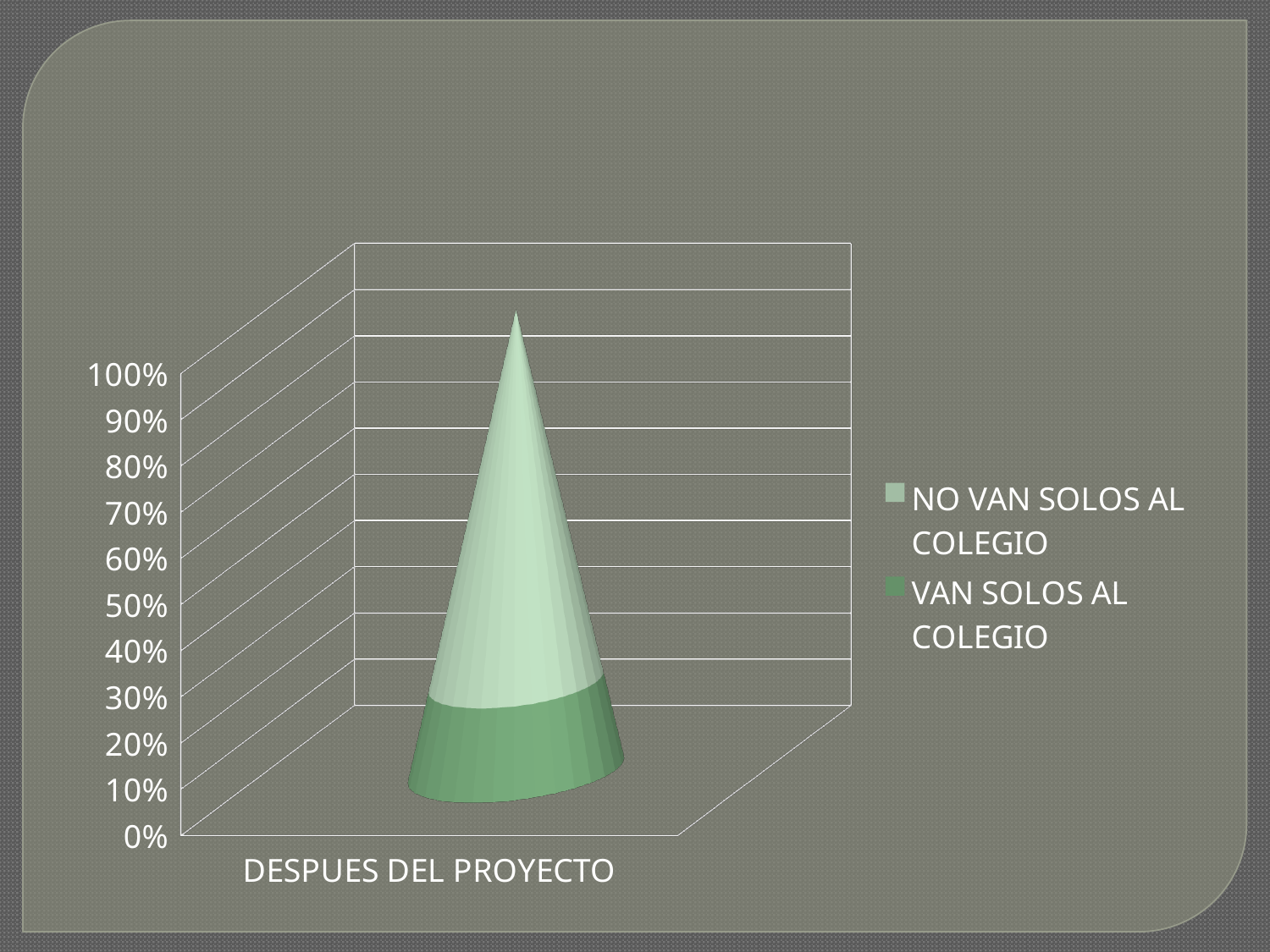
Which series is shown in the lighter green colour in the legend? NO VAN SOLOS AL COLEGIO What kind of chart is shown on the slide? bar chart Is the value for NO VAN SOLOS AL COLEGIO greater or less than 50%? greater Which series has the larger value for DESPUES DEL PROYECTO, NO VAN SOLOS AL COLEGIO or VAN SOLOS AL COLEGIO? NO VAN SOLOS AL COLEGIO What is the label of the category on the x axis? DESPUES DEL PROYECTO How many categories are shown on the x axis? 1 Which series has the smallest share of the stacked bar for DESPUES DEL PROYECTO? VAN SOLOS AL COLEGIO What is the highest value shown on the vertical axis? 100% Is the value for VAN SOLOS AL COLEGIO greater or less than 50%? less How many series does the legend list? 2